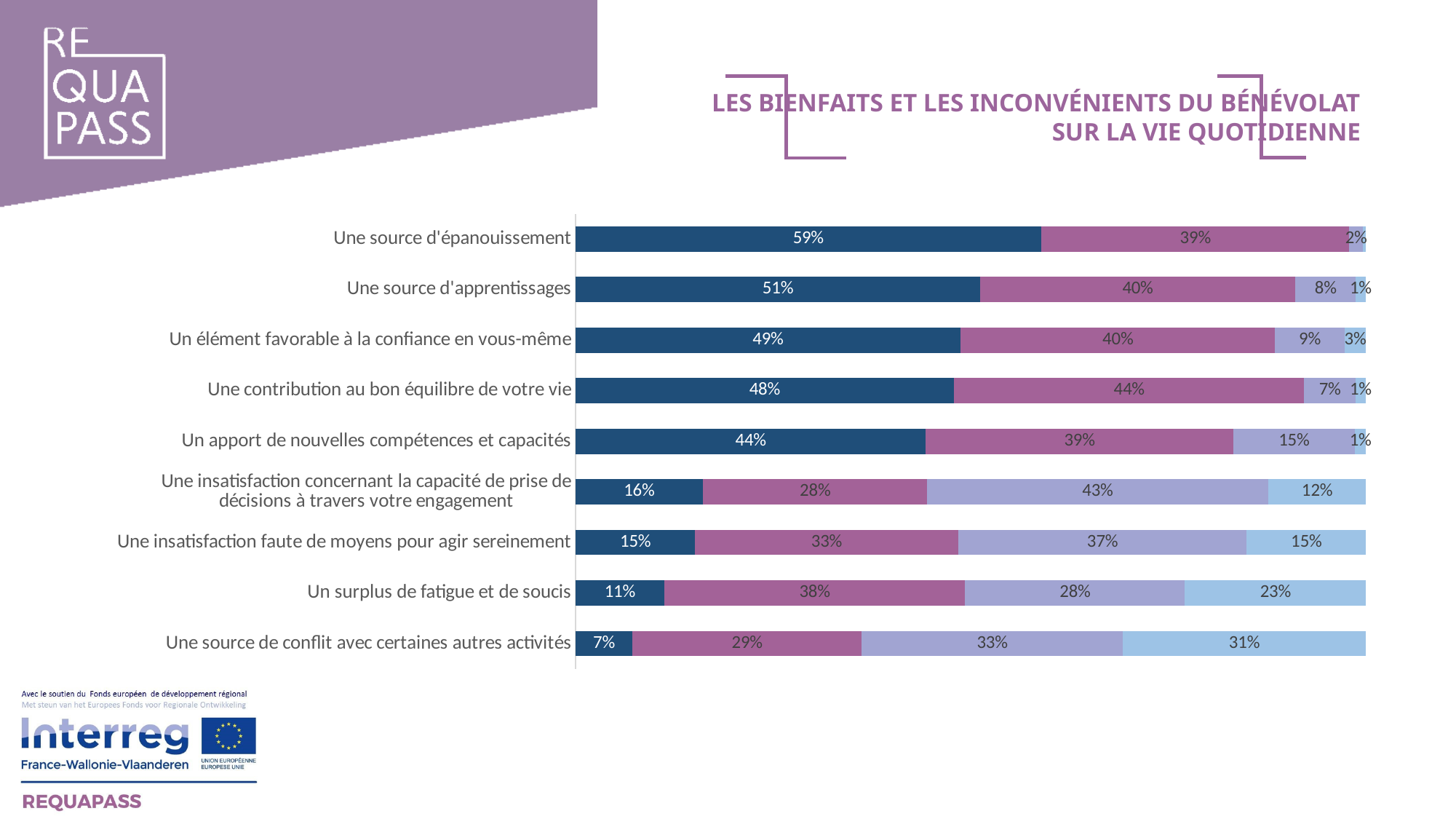
What is the difference between the dark blue segment values for "Une source d'épanouissement" and "Une source d'apprentissages"? 8% How many categories (bars) does the chart show? 9 Which has a larger light blue (last) segment: "Un surplus de fatigue et de soucis" or "Une insatisfaction faute de moyens pour agir sereinement"? Un surplus de fatigue et de soucis Which category has the highest value in the dark blue (first) segment? Une source d'épanouissement Which category has the lowest value in the dark blue (first) segment? Une source de conflit avec certaines autres activités What is the value of the purple (second) segment for "Une contribution au bon équilibre de votre vie"? 44% What is the title of the slide containing the chart? Les bienfaits et les inconvénients du bénévolat sur la vie quotidienne What is the value of the dark blue (first) segment for "Une source d'épanouissement"? 59% What is the value of the lavender (third) segment for "Une insatisfaction concernant la capacité de prise de décisions à travers votre engagement"? 43% What kind of chart is shown on the slide? stacked bar chart What is the value of the dark blue (first) segment for "Un surplus de fatigue et de soucis"? 11% What is the value of the light blue (last) segment for "Une source de conflit avec certaines autres activités"? 31%